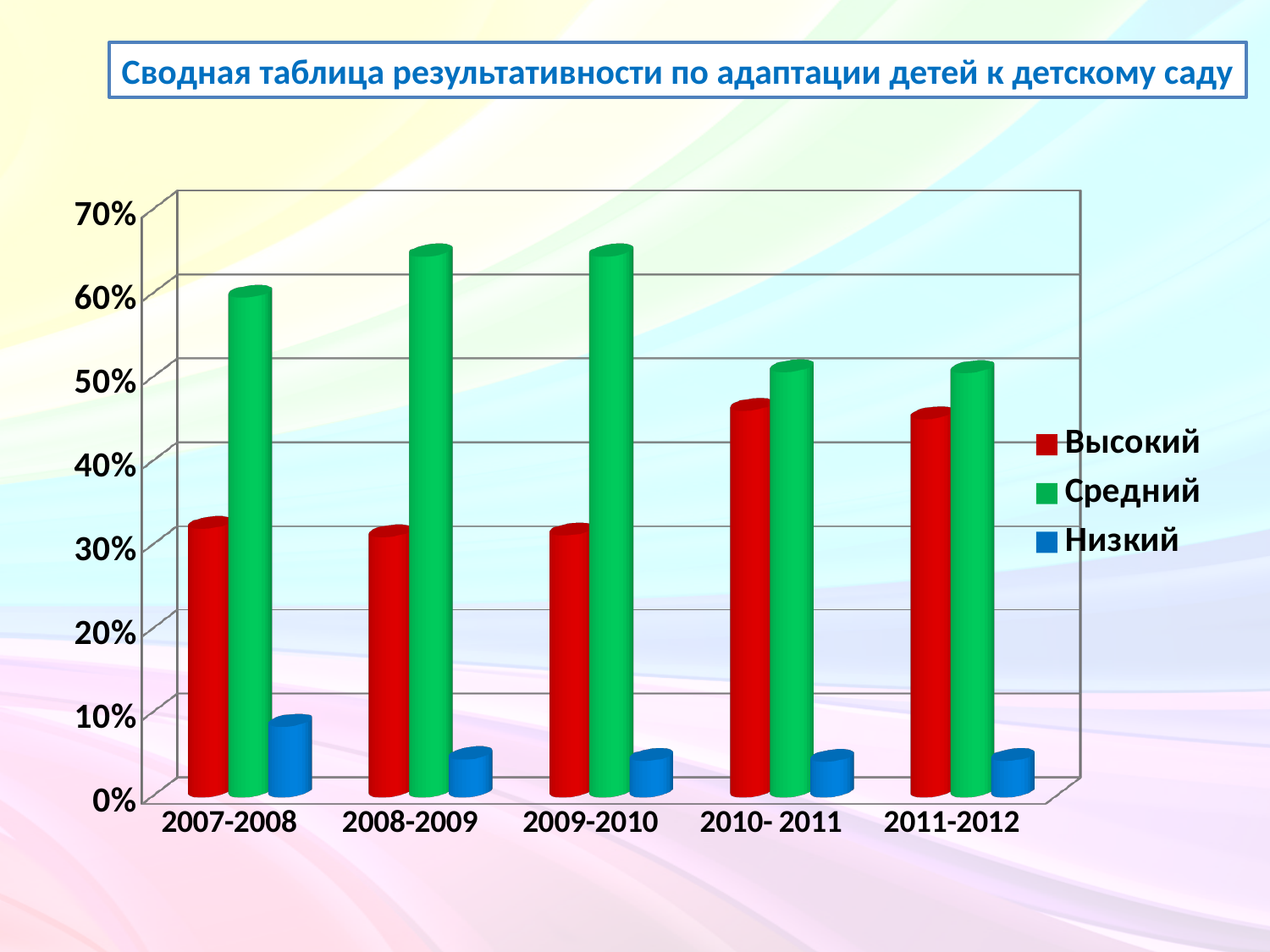
Is the value for Высокий in 2010- 2011 greater or less than 40%? greater How many series does the legend list? 3 Is the value for Низкий in 2009-2010 greater or less than 10%? less In which year is the value for Низкий the highest? 2007-2008 Which is larger in 2010- 2011, Высокий or Средний? Средний Which series has the highest value in 2007-2008? Средний What kind of chart is shown on the slide? bar chart Which is larger for Средний, 2009-2010 or 2011-2012? 2009-2010 Is the value for Средний in 2008-2009 greater or less than 60%? greater Which series has the lowest value in 2011-2012? Низкий How many categories (school years) are shown on the x axis? 5 What colour represents the Низкий series? blue